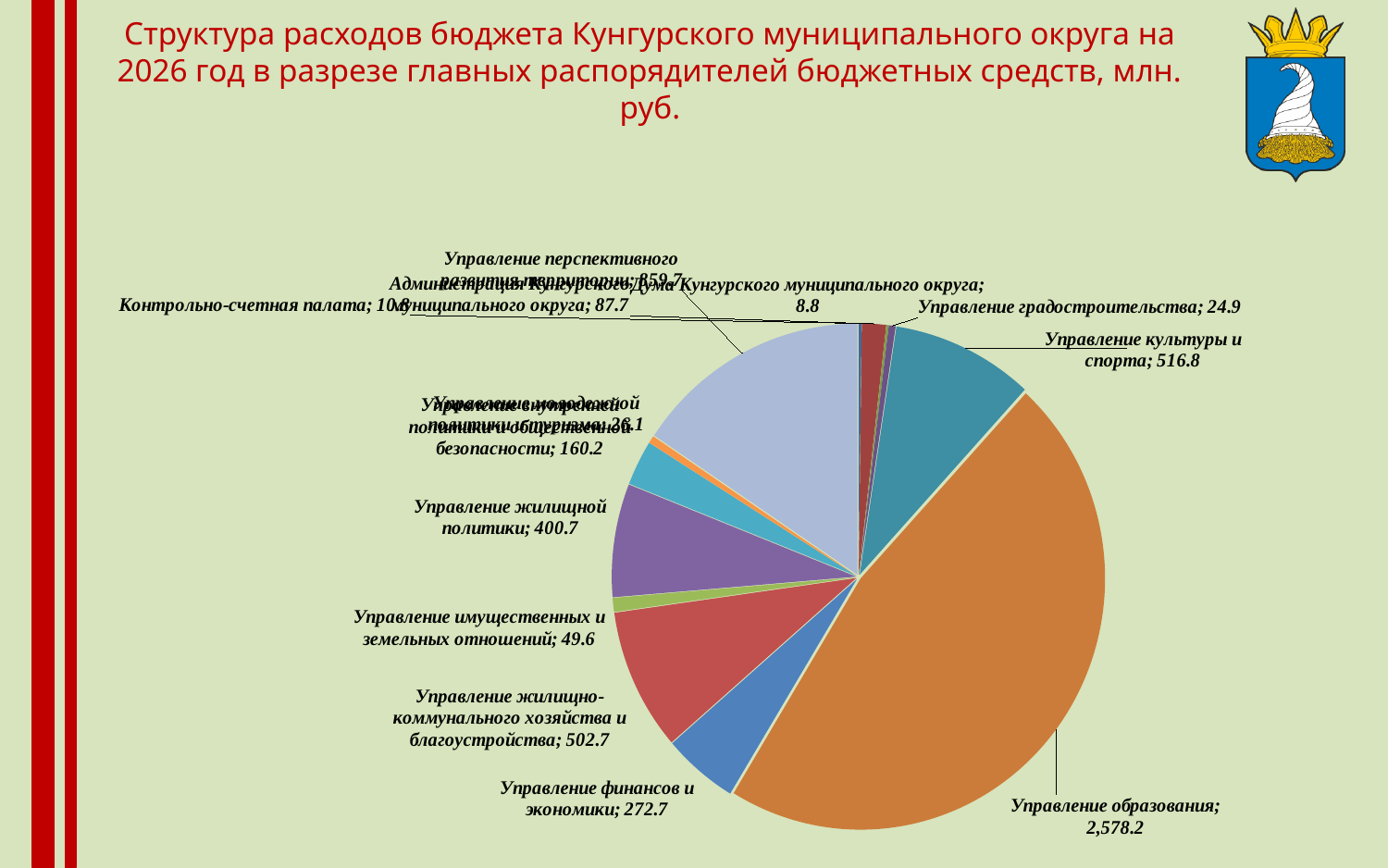
What is the difference between the values for Управление образования and Управление финансов и экономики? 2,305.5 What is the value for Управление жилищной политики? 400.7 What type of chart is shown on the slide? pie chart What is the value for Управление финансов и экономики? 272.7 Which category has the largest slice of the pie? Управление образования According to the chart title, in what units are the values given? млн. руб. What is the value for Управление образования? 2,578.2 Which is larger: Управление культуры и спорта or Управление жилищно-коммунального хозяйства и благоустройства? Управление культуры и спорта What is the value for Управление культуры и спорта? 516.8 What is the difference between the values for Управление жилищной политики and Управление имущественных и земельных отношений? 351.1 What is the value for Управление градостроительства? 24.9 What is the value for Управление жилищно-коммунального хозяйства и благоустройства? 502.7